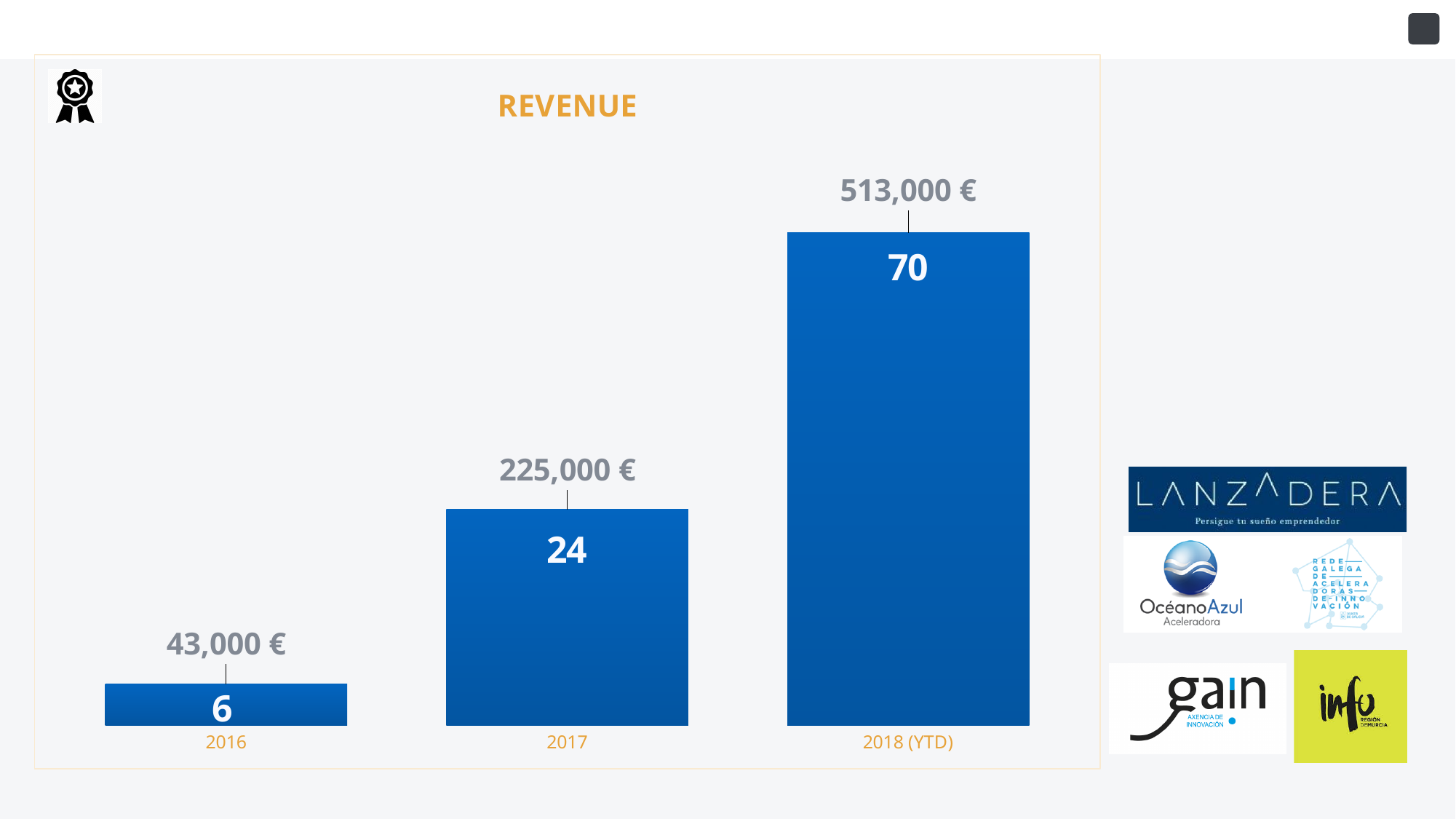
What is the revenue shown for 2017? 225,000 € Which is larger, the revenue for 2017 or for 2016? 2017 What is the revenue shown for 2016? 43,000 € Which year has the highest revenue? 2018 (YTD) Does revenue rise or fall from 2016 to 2018 (YTD)? Rise What is the difference in revenue between 2018 (YTD) and 2017? 288,000 € What is the difference in revenue between 2017 and 2016? 182,000 € What kind of chart is shown on the slide? Bar chart What is the revenue shown for 2018 (YTD)? 513,000 € How many years are shown on the chart? 3 What is the title of the chart? REVENUE Which year has the lowest revenue? 2016